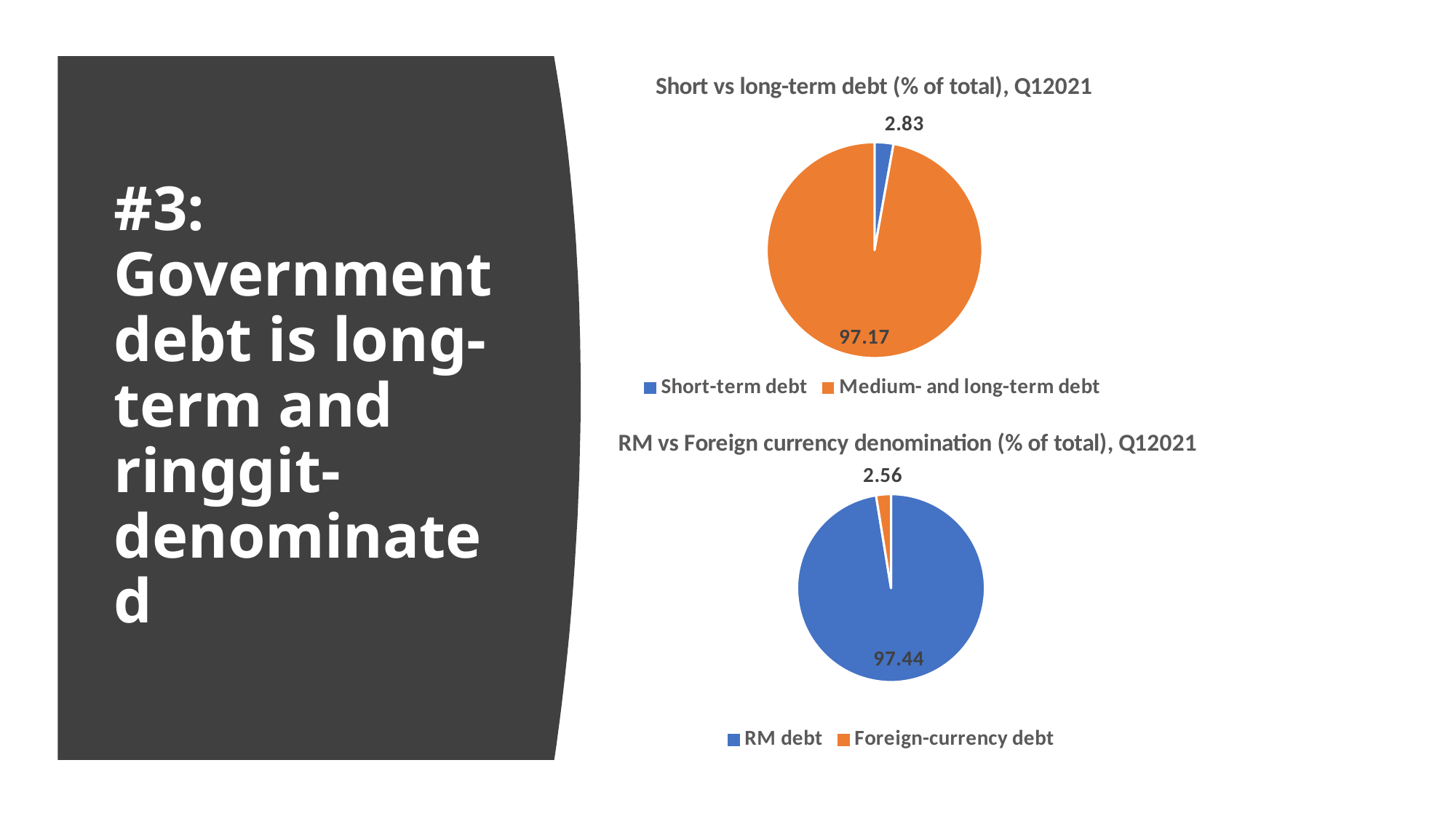
In the 'RM vs Foreign currency denomination (% of total), Q12021' chart, what is the value for Foreign-currency debt? 2.56 In the 'Short vs long-term debt (% of total), Q12021' chart, what colour is the Short-term debt slice? Blue In the 'RM vs Foreign currency denomination (% of total), Q12021' chart, which category has the smallest slice? Foreign-currency debt In the 'RM vs Foreign currency denomination (% of total), Q12021' chart, what is the value for RM debt? 97.44 In the 'RM vs Foreign currency denomination (% of total), Q12021' chart, what is the difference between the RM debt value and the Foreign-currency debt value? 94.88 In the 'Short vs long-term debt (% of total), Q12021' chart, which category has the largest slice? Medium- and long-term debt In the 'RM vs Foreign currency denomination (% of total), Q12021' chart, which is larger, RM debt or Foreign-currency debt? RM debt In the 'Short vs long-term debt (% of total), Q12021' chart, what is the value for Medium- and long-term debt? 97.17 In the 'Short vs long-term debt (% of total), Q12021' chart, what is the value for Short-term debt? 2.83 What kind of chart is the 'Short vs long-term debt (% of total), Q12021' chart? Pie chart How many categories does the legend of the 'RM vs Foreign currency denomination (% of total), Q12021' chart list? 2 In the 'Short vs long-term debt (% of total), Q12021' chart, what is the difference between the Medium- and long-term debt value and the Short-term debt value? 94.34